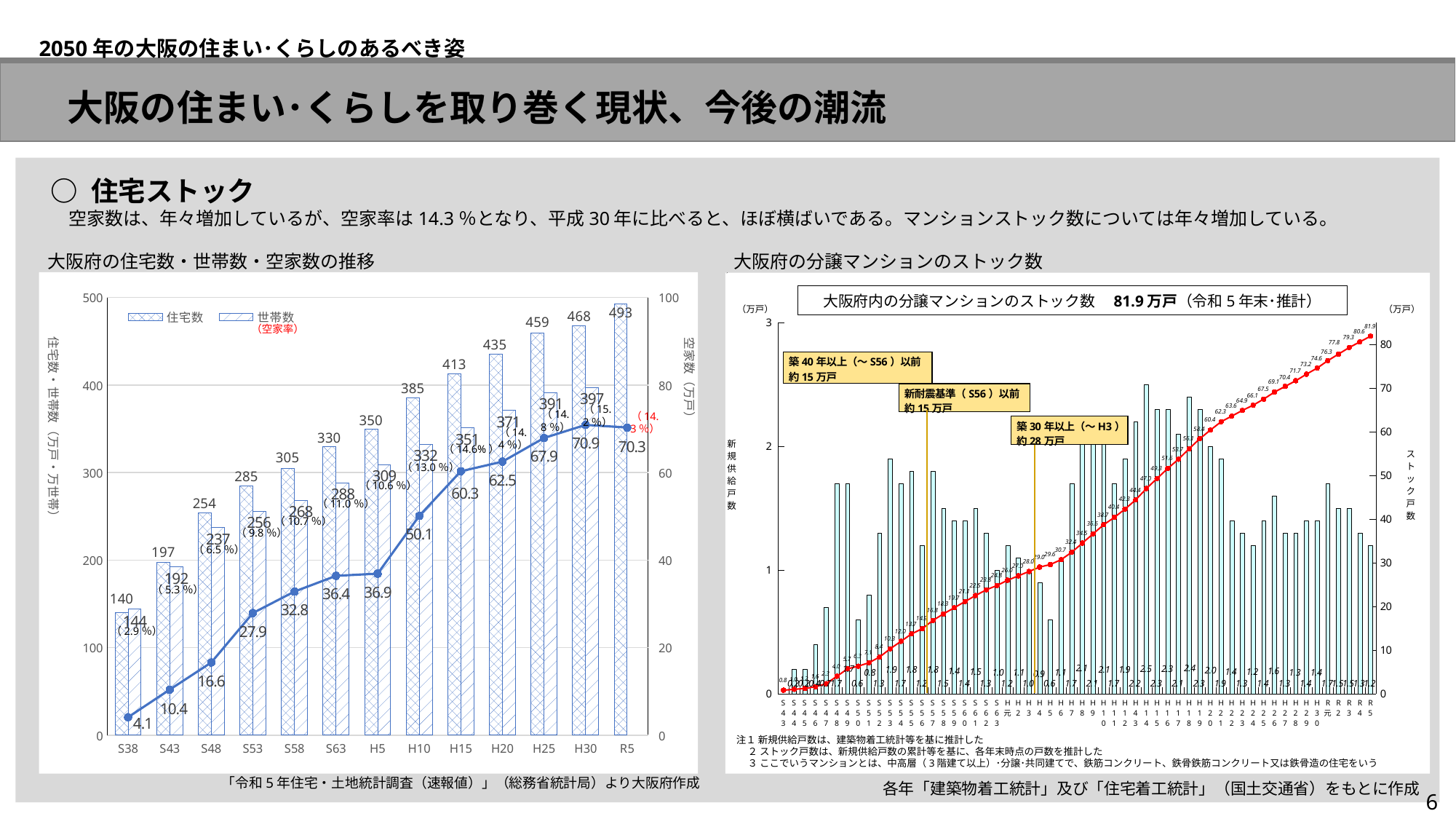
In the chart 大阪府の住宅数・世帯数・空家数の推移, what is the difference between the 住宅数 for R5 and the 住宅数 for H30? 25 In the chart 大阪府の分譲マンションのストック数, does the ストック戸数 line rise or fall over time? rise In the chart 大阪府の住宅数・世帯数・空家数の推移, does the 住宅数 rise or fall from S38 to R5? rise In the chart 大阪府の住宅数・世帯数・空家数の推移, which is larger: the 住宅数 for H10 or the 世帯数 for H10? 住宅数 for H10 In the chart 大阪府の住宅数・世帯数・空家数の推移, which year has the highest 空家数? H30 In the chart 大阪府の住宅数・世帯数・空家数の推移, what is the 空家数 value for H15? 60.3 In the chart 大阪府の住宅数・世帯数・空家数の推移, what is the 住宅数 value for R5? 493 In the chart 大阪府の住宅数・世帯数・空家数の推移, how many years are shown on the x axis? 13 In the chart 大阪府の住宅数・世帯数・空家数の推移, what is the 空家率 shown for S38? 2.9% In the chart 大阪府の住宅数・世帯数・空家数の推移, which year has the lowest 住宅数? S38 In the chart 大阪府の分譲マンションのストック数, what is the stock of 分譲マンション in Osaka Prefecture at the end of 令和5年? 81.9万戸 In the chart 大阪府の住宅数・世帯数・空家数の推移, what is the 世帯数 value for H30? 397